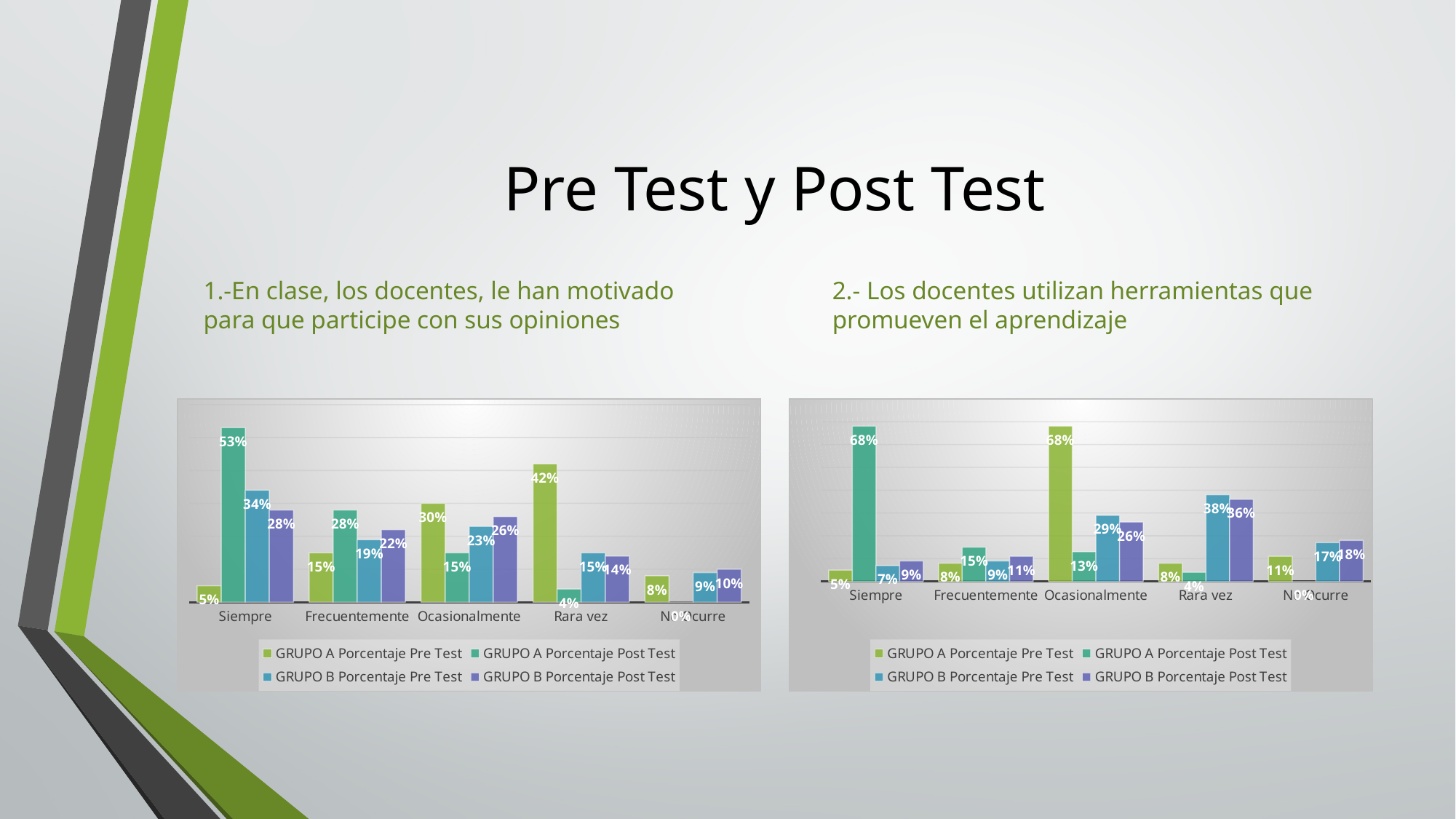
In the right chart (question 2), which category has the lowest GRUPO A Porcentaje Post Test value? No ocurre What type of chart is the left chart (question 1)? Bar chart In the right chart (question 2), which is larger for Ocasionalmente: GRUPO B Pre Test or GRUPO B Post Test? GRUPO B Pre Test How many series does the legend of the right chart (question 2) list? 4 In the left chart (question 1), what is the GRUPO A Porcentaje Post Test value for Siempre? 53% In the right chart (question 2), what is the GRUPO B Porcentaje Pre Test value for Rara vez? 38% In the left chart (question 1), what is the difference between the GRUPO B Pre Test and GRUPO B Post Test values for Siempre? 6% In the left chart (question 1), what is the GRUPO A Porcentaje Pre Test value for Rara vez? 42% In the right chart (question 2), what is the GRUPO A Porcentaje Post Test value for Siempre? 68% In the right chart (question 2), what is the difference between the GRUPO A Pre Test value for Ocasionalmente and the GRUPO A Post Test value for Ocasionalmente? 55% In the left chart (question 1), which category has the highest GRUPO A Porcentaje Pre Test value? Rara vez In the left chart (question 1), how many categories are shown on the x axis? 5